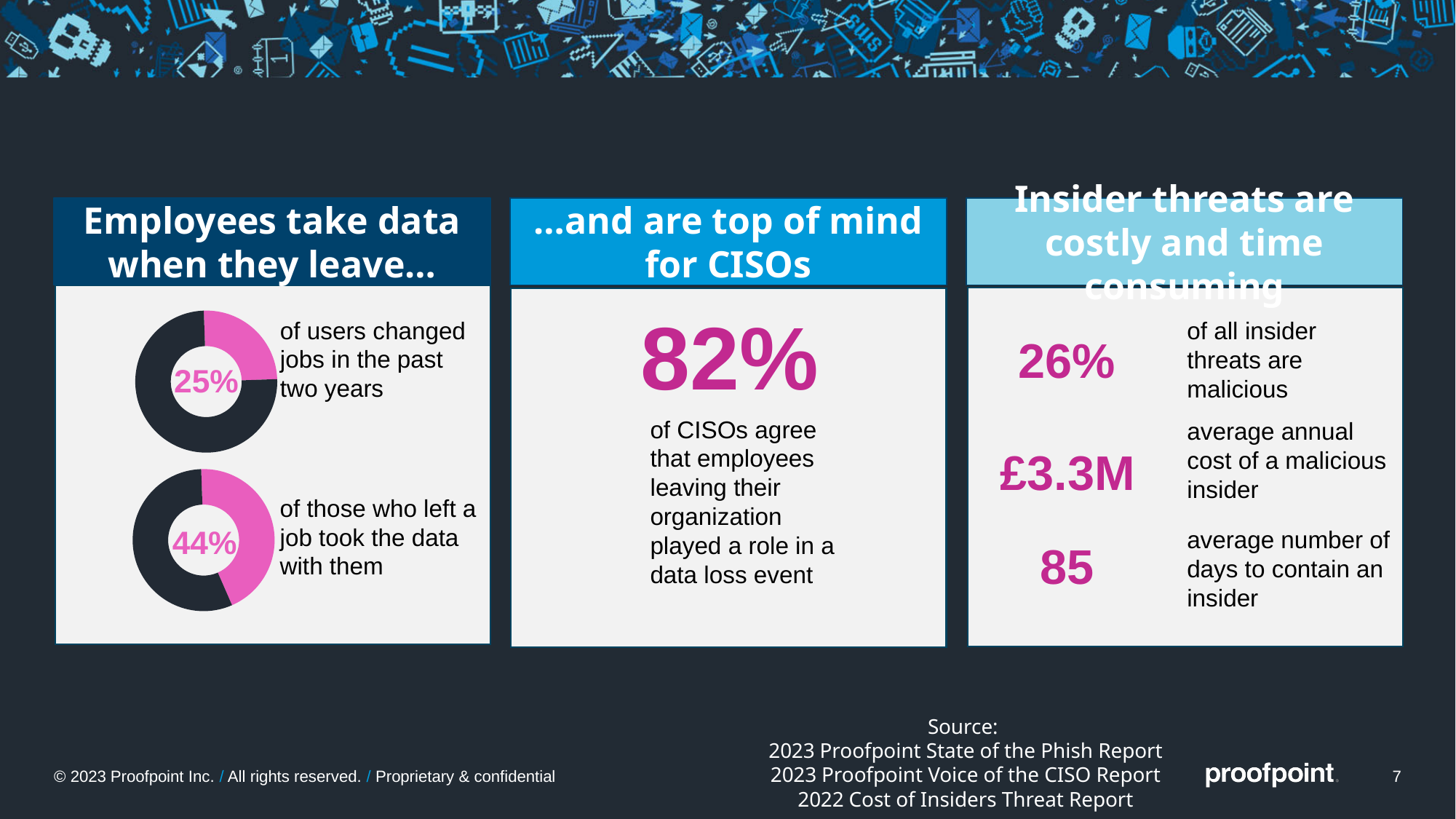
In the lower donut chart on the left panel, is the highlighted value greater or less than 50%? less What is the title of the panel containing the two donut charts? Employees take data when they leave… Which donut chart on the left panel shows the larger highlighted share: the upper one (users who changed jobs) or the lower one (those who took data)? The lower one (44%) In the lower donut chart on the left panel, what percentage of those who left a job took the data with them? 44% What kind of chart is used in the left panel to show the 25% and 44% figures? Donut chart In the upper donut chart on the left panel, what share of the ring is highlighted in pink? 25% What colour is used for the highlighted segment in both donut charts on the left panel? Pink How many donut charts are shown on the slide? 2 What is the difference in percentage points between the lower donut chart value (44%) and the upper donut chart value (25%)? 19 percentage points In the upper donut chart on the left panel, what percentage of users changed jobs in the past two years? 25% In the upper donut chart on the left panel, is the highlighted value greater or less than 20%? greater